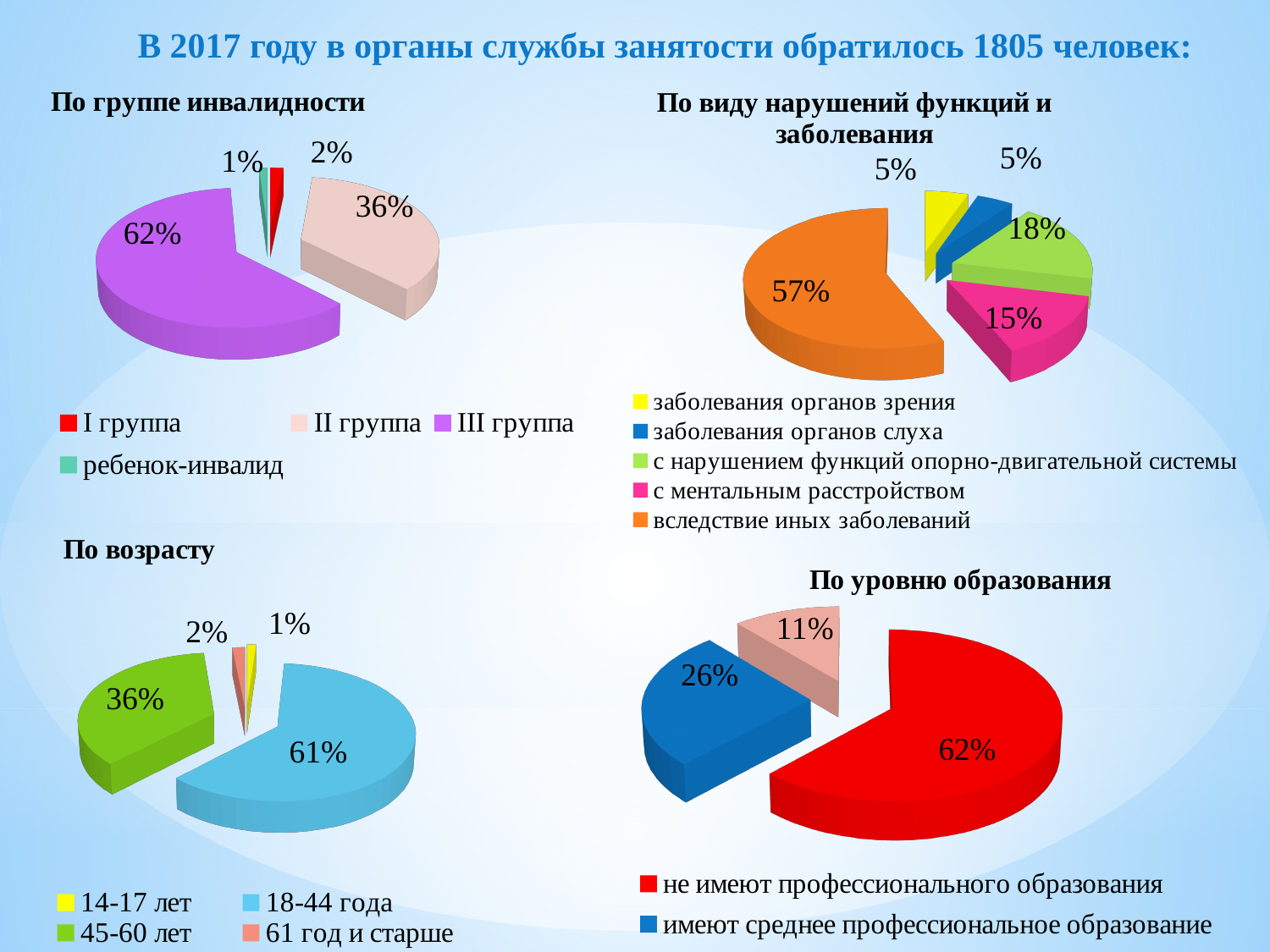
In the chart 'По возрасту', what share is '45-60 лет'? 36% In the chart 'По виду нарушений функций и заболевания', what share is 'с нарушением функций опорно-двигательной системы'? 18% In the chart 'По группе инвалидности', what share is III группа? 62% In the chart 'По виду нарушений функций и заболевания', what share is 'вследствие иных заболеваний'? 57% In the chart 'По возрасту', what share is '18-44 года'? 61% In the chart 'По возрасту', which is larger: '14-17 лет' or '61 год и старше'? 61 год и старше In the chart 'По группе инвалидности', what share is II группа? 36% How many categories does the legend of the chart 'По виду нарушений функций и заболевания' list? 5 What type of chart is used for 'По уровню образования'? pie chart In the chart 'По виду нарушений функций и заболевания', what is the difference between 'с нарушением функций опорно-двигательной системы' and 'с ментальным расстройством'? 3% In the chart 'По уровню образования', what share is 'не имеют профессионального образования'? 62% In the chart 'По группе инвалидности', which category has the smallest share? ребенок-инвалид